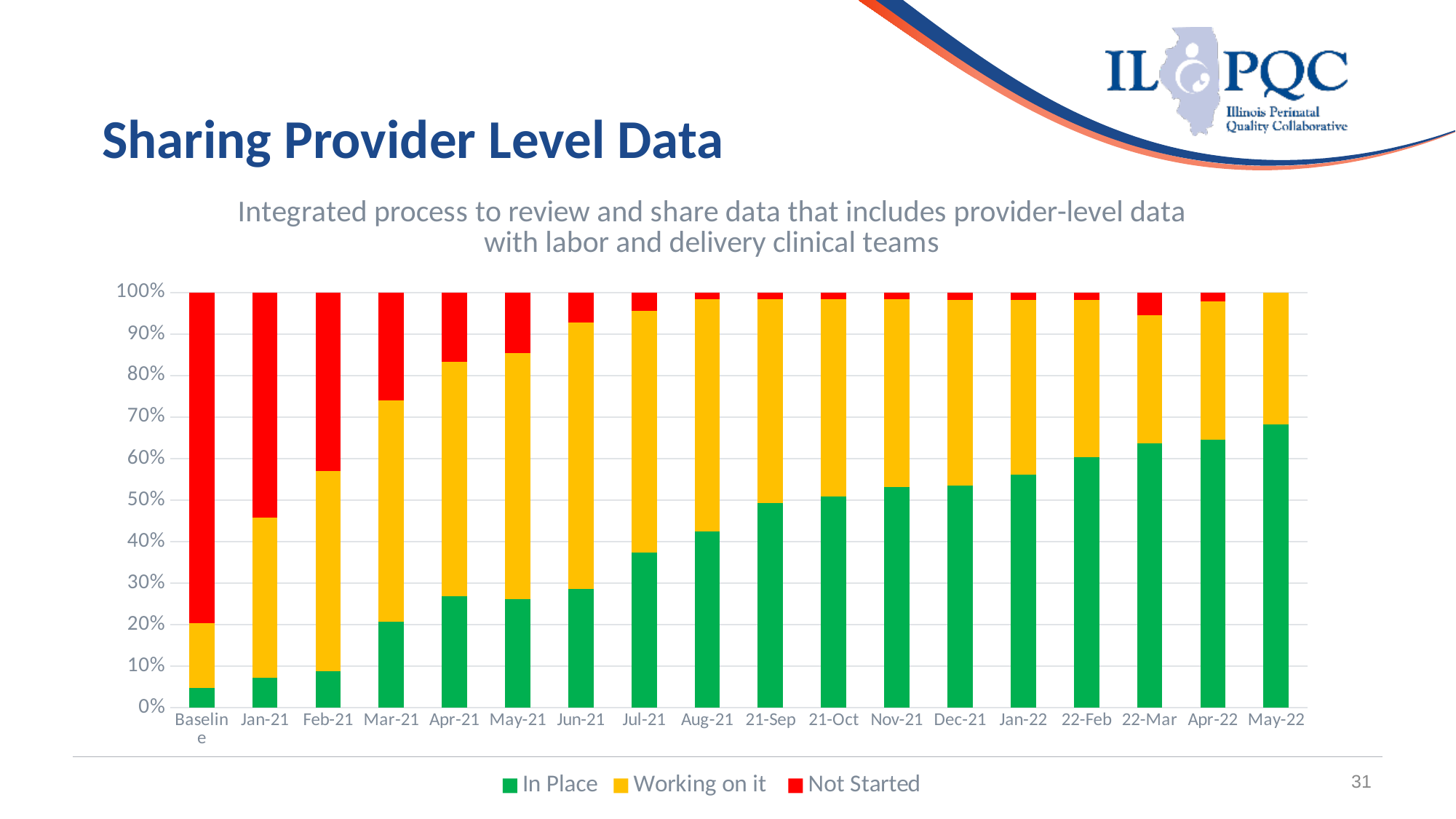
What kind of chart is shown on the slide? Stacked bar chart Is the 'In Place' value for May-22 greater or less than 60%? greater How many series does the legend list? 3 How many time periods (categories) are plotted along the x axis? 18 Is the 'In Place' value for Jul-21 greater or less than 40%? less What are the three series named in the legend? In Place, Working on it, Not Started Which period has the lowest 'In Place' share? Baseline Which colour represents the 'Not Started' series? Red Which period has the largest 'Not Started' share? Baseline Which period has the highest 'In Place' share? May-22 Which has the larger 'Not Started' share, Jan-21 or Jun-21? Jan-21 Does the 'In Place' share rise or fall from Baseline to May-22? Rise